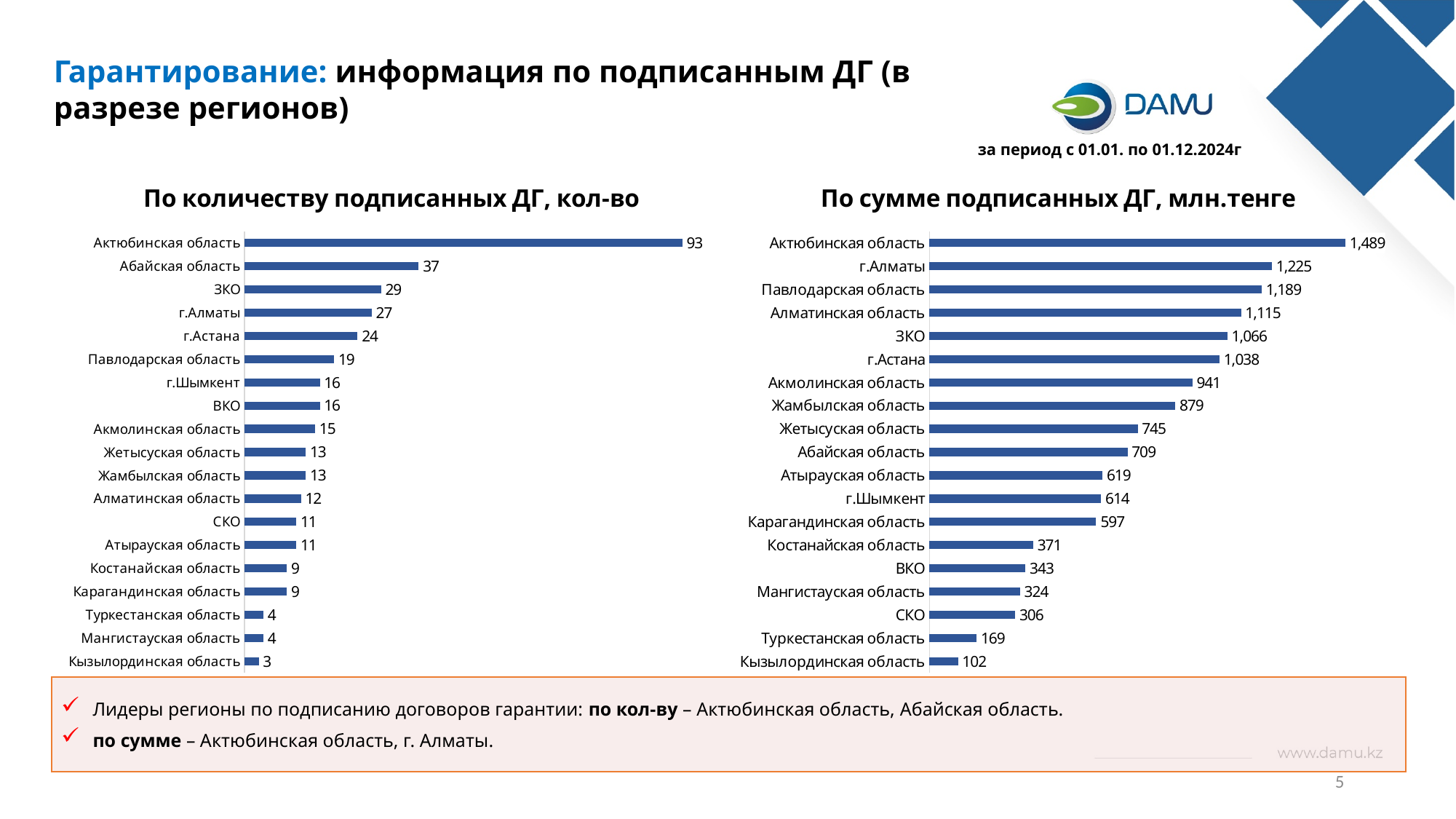
In the chart 'По сумме подписанных ДГ, млн.тенге', what is the value for г.Астана? 1,038 In the chart 'По сумме подписанных ДГ, млн.тенге', what is the difference between г.Алматы and Павлодарская область? 36 In the chart 'По количеству подписанных ДГ, кол-во', which is larger: г.Астана or Павлодарская область? г.Астана In the chart 'По количеству подписанных ДГ, кол-во', what is the value for Абайская область? 37 How many regions are shown in the chart 'По сумме подписанных ДГ, млн.тенге'? 19 In the chart 'По количеству подписанных ДГ, кол-во', which region has the highest value? Актюбинская область In the chart 'По количеству подписанных ДГ, кол-во', what is the difference between Актюбинская область and Абайская область? 56 In the chart 'По сумме подписанных ДГ, млн.тенге', which is larger: ЗКО or Акмолинская область? ЗКО In the chart 'По сумме подписанных ДГ, млн.тенге', what is the value for Карагандинская область? 597 What type of chart is 'По количеству подписанных ДГ, кол-во'? Bar chart In the chart 'По сумме подписанных ДГ, млн.тенге', which region has the lowest value? Кызылординская область What period does the slide state the data covers? с 01.01. по 01.12.2024г